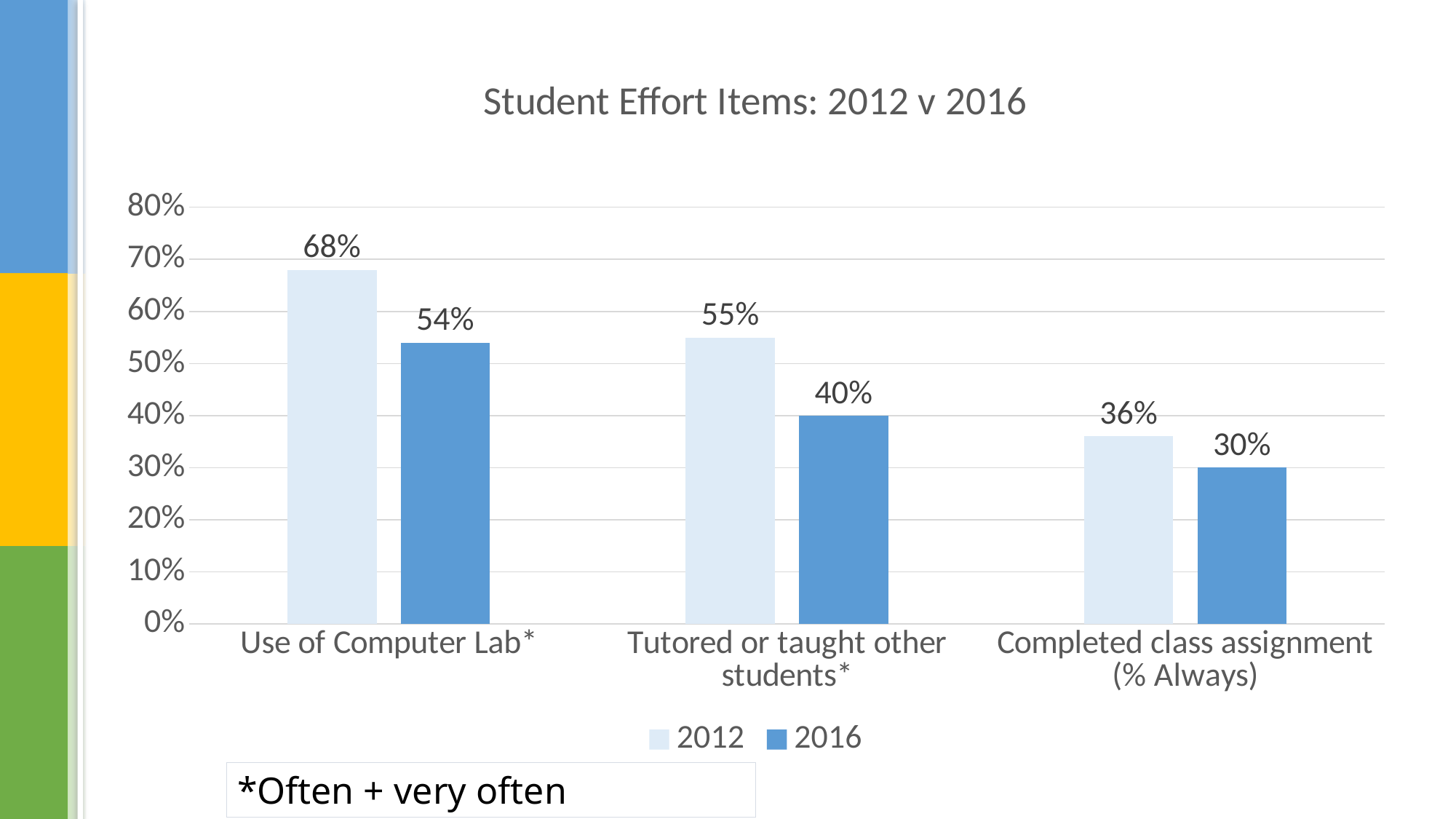
What is the title of the chart? Student Effort Items: 2012 v 2016 What is the difference between the 2012 and 2016 values for Use of Computer Lab*? 14% What kind of chart is shown on the slide? Bar chart What is the 2016 value for Completed class assignment (% Always)? 30% Which category has the highest 2012 value? Use of Computer Lab* Which category has the lowest 2016 value? Completed class assignment (% Always) How many series does the legend list? 2 How many categories are shown on the x axis? 3 Which is larger: the 2016 value for Use of Computer Lab* or the 2012 value for Tutored or taught other students*? 2012 value for Tutored or taught other students* What is the 2012 value for Use of Computer Lab*? 68% What is the 2016 value for Tutored or taught other students*? 40% What is the difference between the 2012 and 2016 values for Tutored or taught other students*? 15%